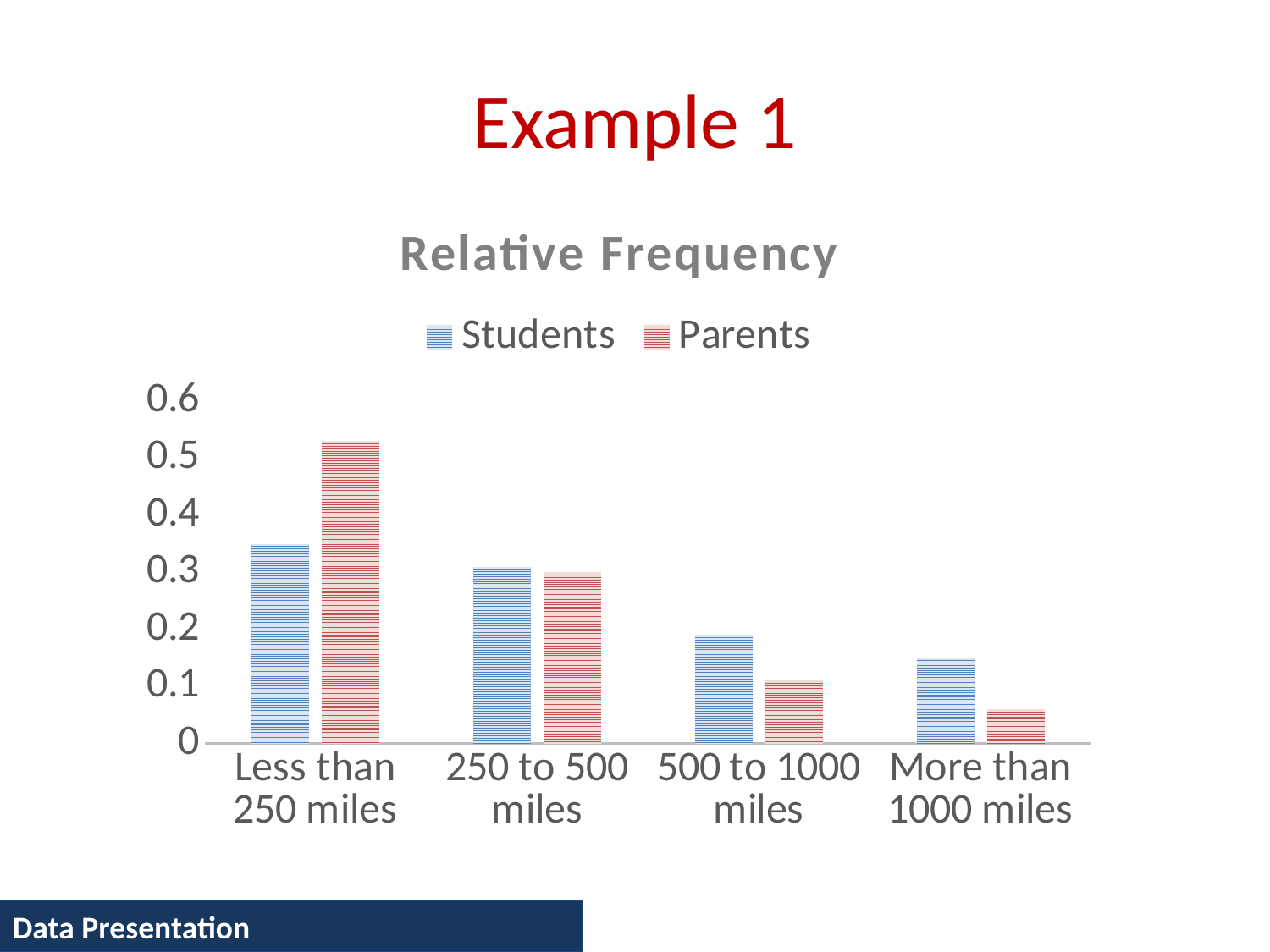
What is the title of the chart? Relative Frequency How many series does the legend list? 2 Which category has the lowest value for Parents? More than 1000 miles Which category has the lowest value for Students? More than 1000 miles For 500 to 1000 miles, which series has the larger value, Students or Parents? Students How many categories are shown on the x axis? 4 Which series is shown in red? Parents Do the Parents values rise or fall moving from Less than 250 miles to More than 1000 miles? fall What kind of chart is shown on the slide? bar chart Is the value for Parents in the More than 1000 miles category greater or less than 0.1? less For Less than 250 miles, which series has the larger value, Students or Parents? Parents Which category has the highest value for Parents? Less than 250 miles